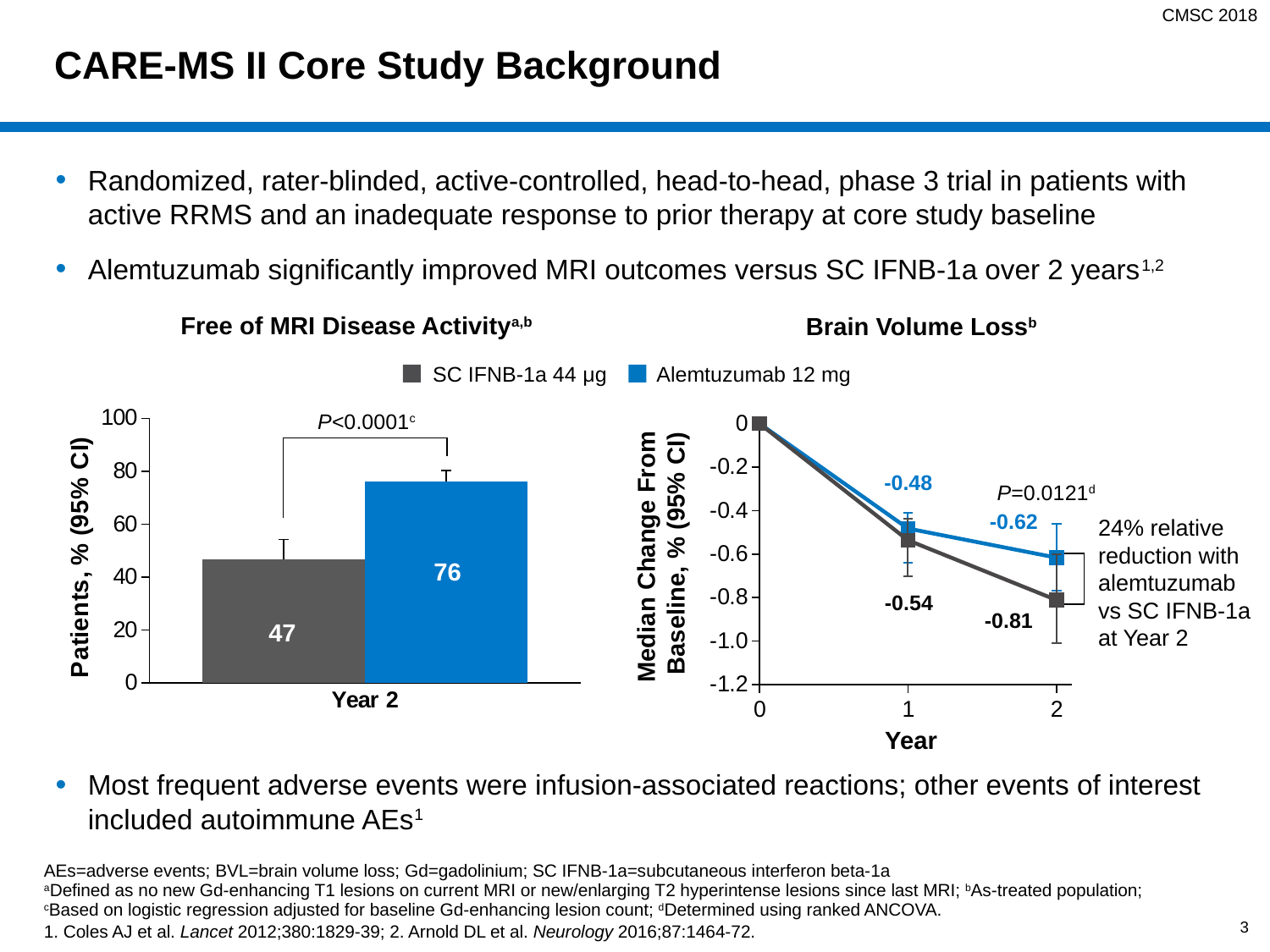
In the Brain Volume Loss chart, what is the median change from baseline for Alemtuzumab 12 mg at Year 2? -0.62 What kind of chart is the Free of MRI Disease Activity chart? Bar chart What kind of chart is the Brain Volume Loss chart? Line chart In the Brain Volume Loss chart, do the values rise or fall from Year 0 to Year 2? Fall In the Free of MRI Disease Activity chart, what percentage of patients on SC IFNB-1a 44 µg were free of MRI disease activity at Year 2? 47 How many series does the legend list? 2 In the Free of MRI Disease Activity chart, what percentage of patients on Alemtuzumab 12 mg were free of MRI disease activity at Year 2? 76 In the Brain Volume Loss chart, what is the median change from baseline for SC IFNB-1a 44 µg at Year 1? -0.54 In the Free of MRI Disease Activity chart, what is the difference between the Alemtuzumab 12 mg and SC IFNB-1a 44 µg values at Year 2? 29 In the Brain Volume Loss chart, what is the median change from baseline for SC IFNB-1a 44 µg at Year 2? -0.81 In the Free of MRI Disease Activity chart, which treatment has the higher percentage of patients free of MRI disease activity? Alemtuzumab 12 mg In the Brain Volume Loss chart, what is the median change from baseline for Alemtuzumab 12 mg at Year 1? -0.48